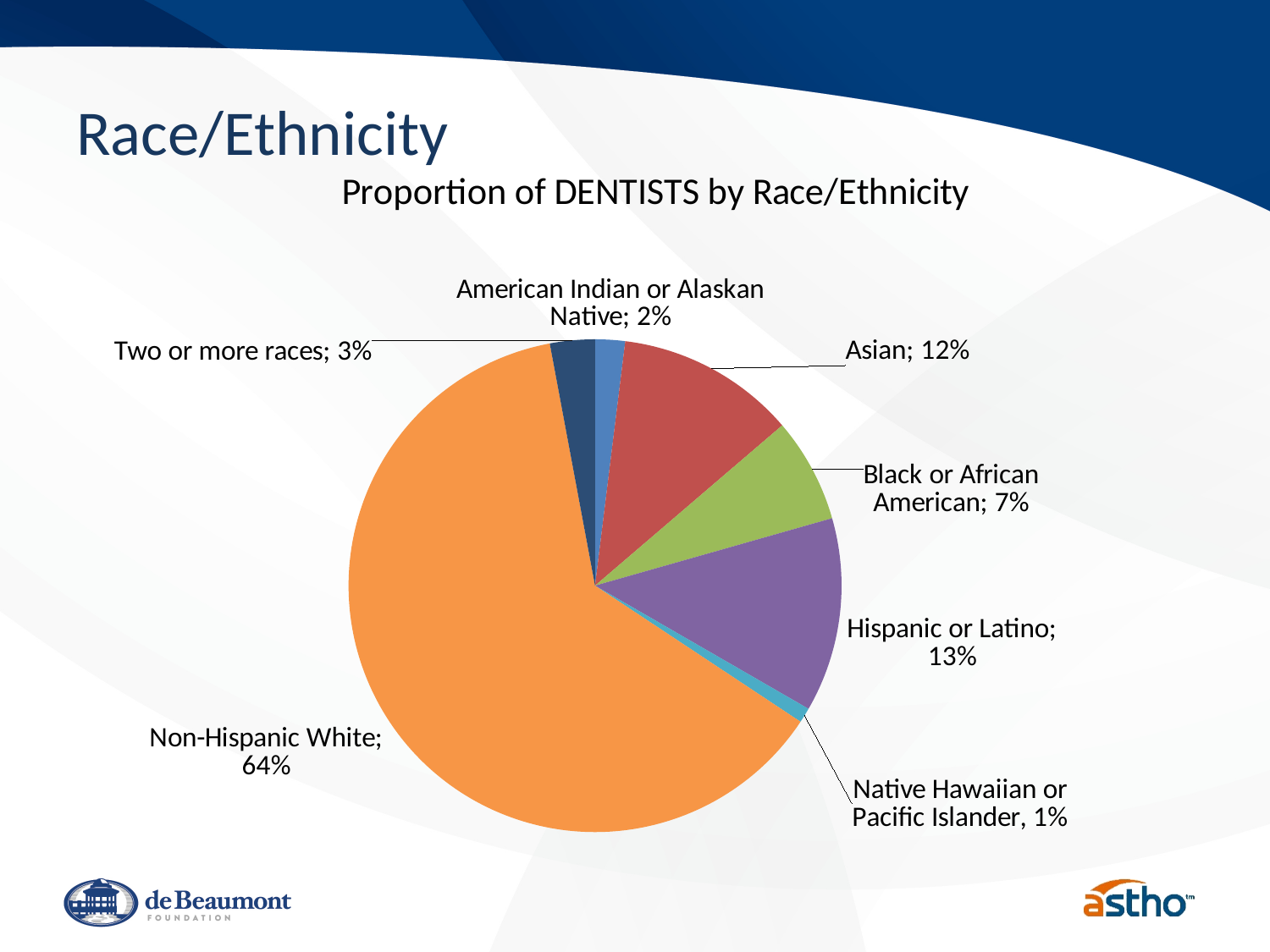
Which race/ethnicity group has the smallest share of dentists? Native Hawaiian or Pacific Islander Which group has a larger share of dentists, Asian or Black or African American? Asian What percentage of dentists are Hispanic or Latino? 13% What percentage of dentists are Native Hawaiian or Pacific Islander? 1% What is the title of the chart? Proportion of DENTISTS by Race/Ethnicity What percentage of dentists are Non-Hispanic White? 64% Which race/ethnicity group has the largest share of dentists? Non-Hispanic White What percentage of dentists are Black or African American? 7% What type of chart is shown on the slide? pie chart How many race/ethnicity categories are shown in the pie chart? 7 What percentage of dentists are Asian? 12% What is the difference in percentage points between the Non-Hispanic White share and the Hispanic or Latino share? 51